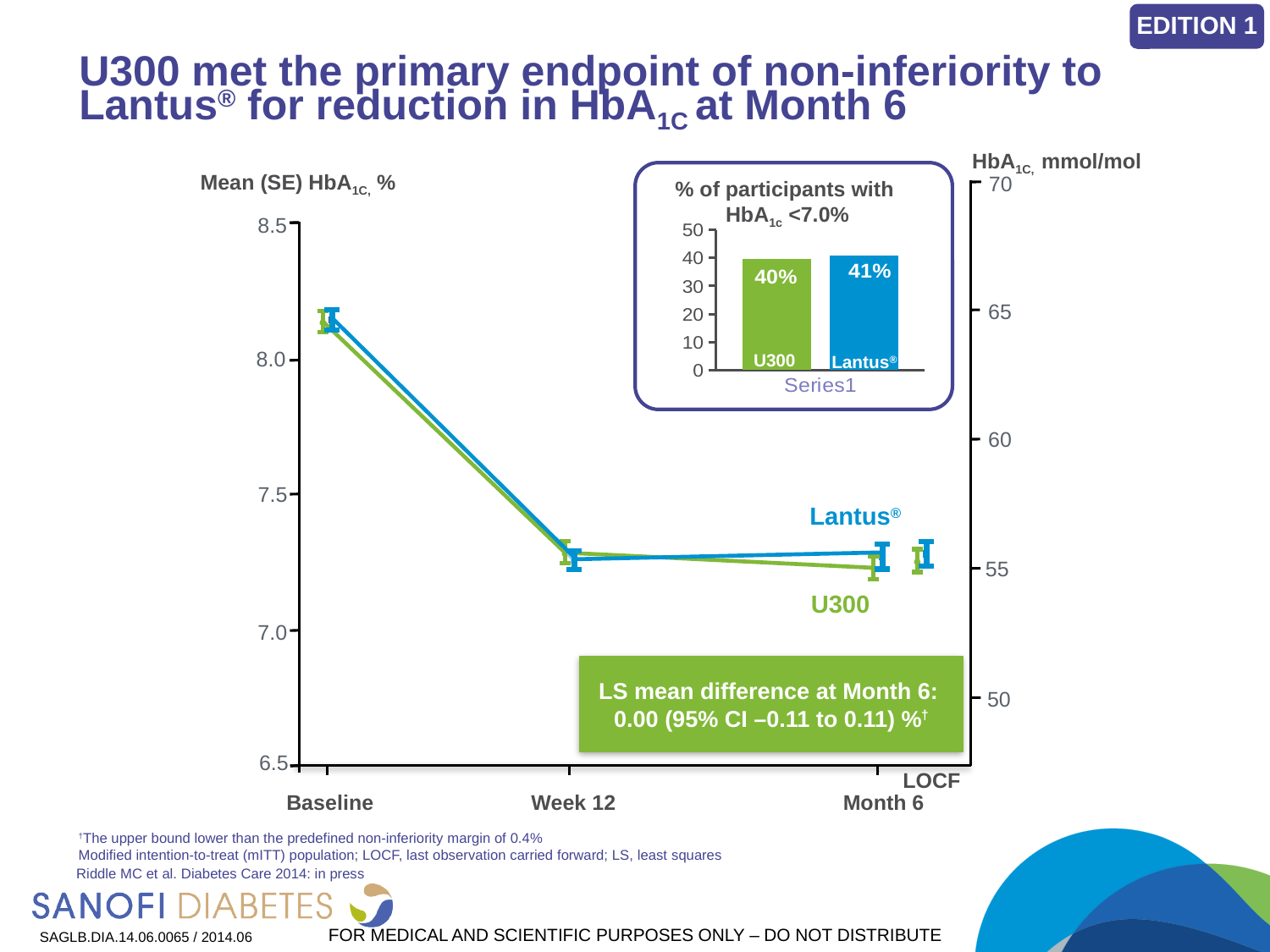
What kind of chart is the inset chart titled '% of participants with HbA1c <7.0%'? Bar chart In the inset bar chart '% of participants with HbA1c <7.0%', what is the difference between the Lantus and U300 values? 1% In the main line chart of Mean (SE) HbA1c, %, is the Lantus value at Week 12 greater or less than 7.5? less In the main line chart of Mean (SE) HbA1c, %, is the U300 value at Month 6 greater or less than 7.0? greater What kind of chart is the main chart showing Mean (SE) HbA1c, %? Line chart In the main line chart of Mean (SE) HbA1c, %, how many time points are shown on the x axis? 3 In the inset bar chart '% of participants with HbA1c <7.0%', what is the value for U300? 40% In the inset bar chart '% of participants with HbA1c <7.0%', which treatment has the higher percentage? Lantus In the inset bar chart '% of participants with HbA1c <7.0%', how many bars are shown? 2 In the main line chart of Mean (SE) HbA1c, %, is the U300 value at Baseline greater or less than 8.0? greater In the inset bar chart '% of participants with HbA1c <7.0%', what is the value for Lantus? 41% In the main line chart of Mean (SE) HbA1c, %, do the values rise or fall from Baseline to Week 12? Fall